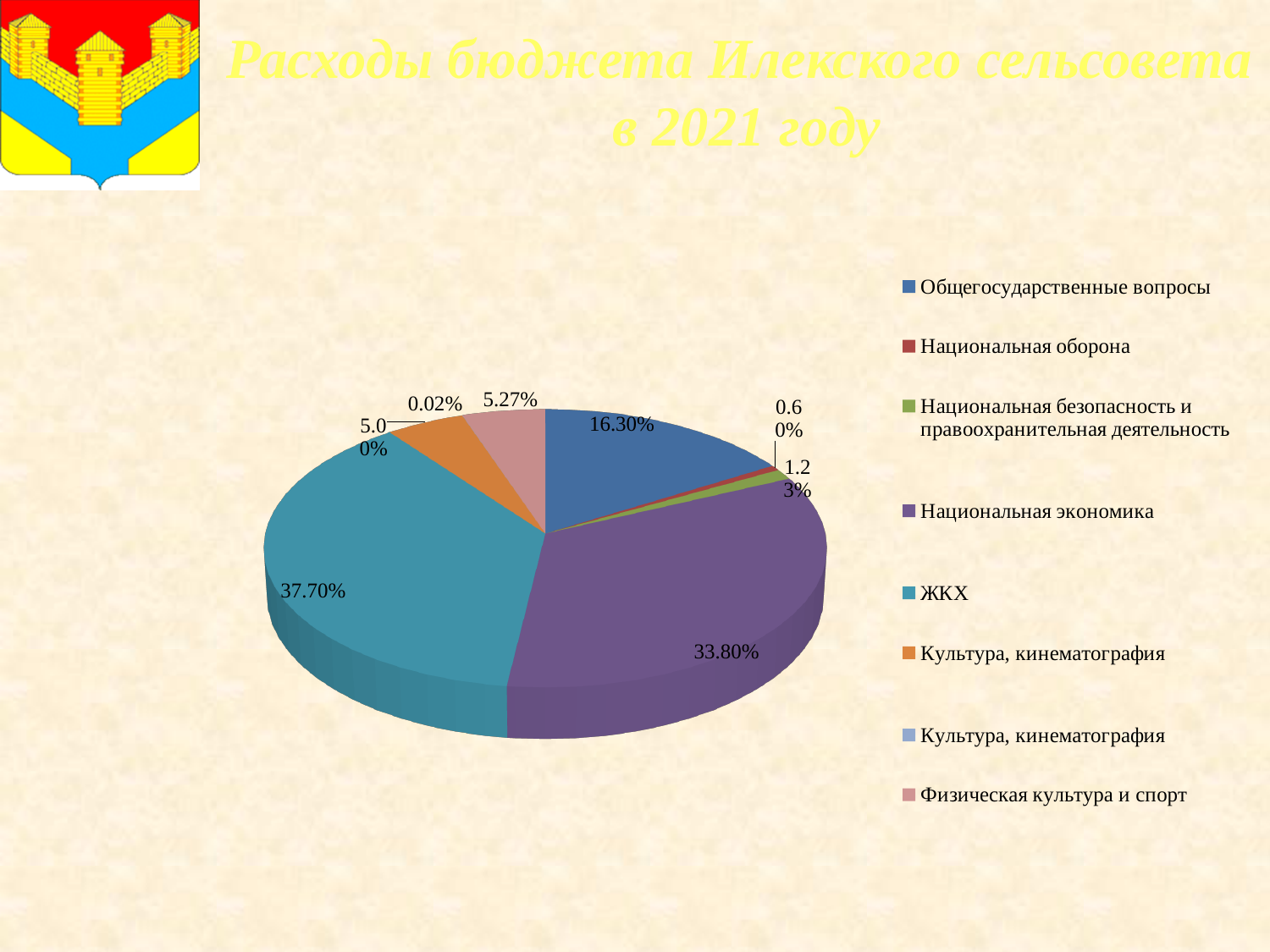
What percentage is shown for Общегосударственные вопросы? 16.30% What type of chart is shown on the slide? pie chart By how many percentage points does the ЖКХ share exceed the Национальная экономика share? 3.90% What percentage of the budget expenses goes to ЖКХ? 37.70% What is the title of the chart on the slide? Расходы бюджета Илекского сельсовета в 2021 году How many entries does the legend list? 8 Which category has the largest share of the pie? ЖКХ By how many percentage points does Общегосударственные вопросы exceed Физическая культура и спорт? 11.03% What percentage is shown for Национальная экономика? 33.80% What percentage is shown for Физическая культура и спорт? 5.27% Which is larger: the share for ЖКХ or the share for Национальная экономика? ЖКХ What is the smallest percentage value labelled on the pie chart? 0.02%